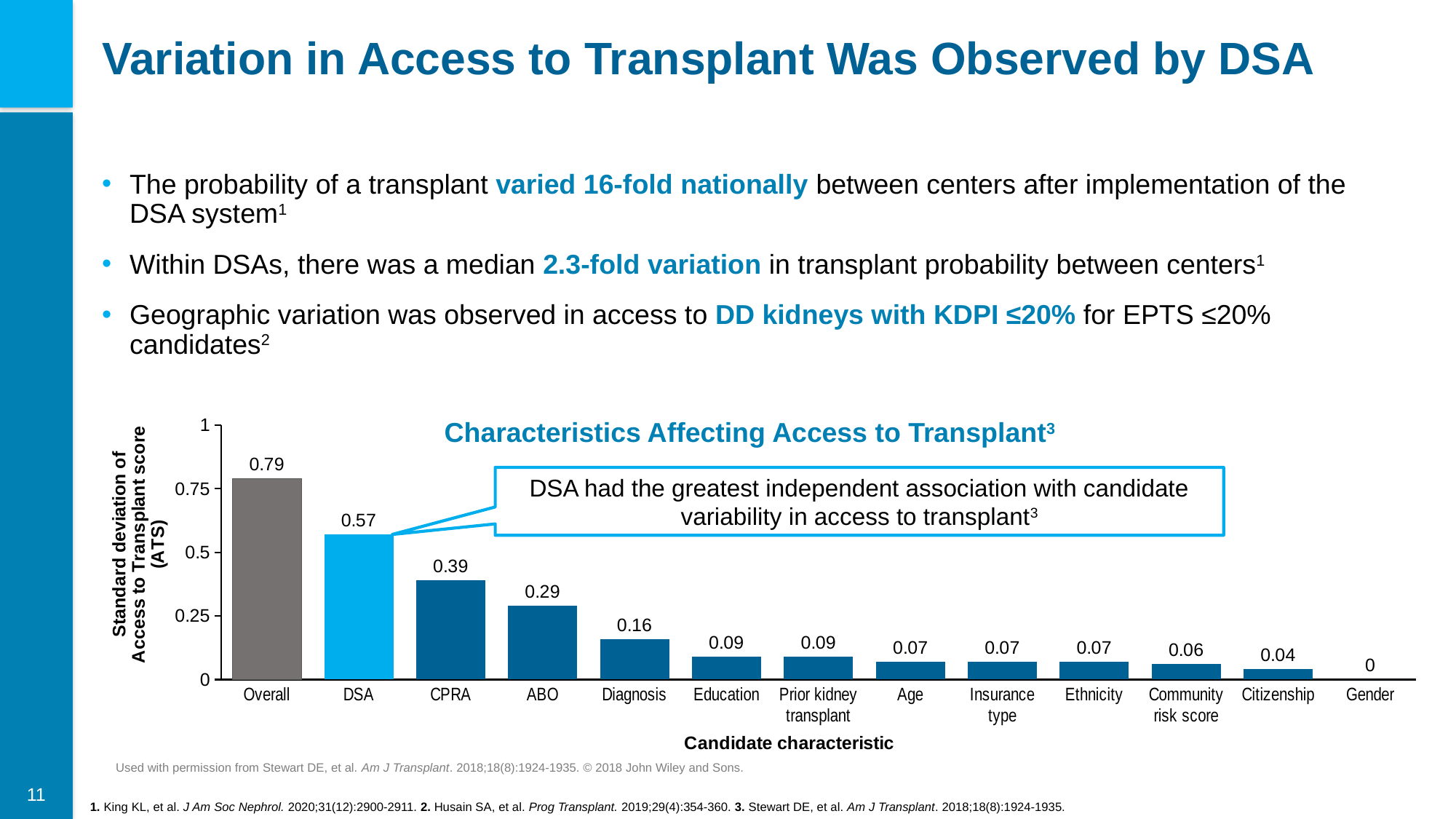
How many candidate characteristics are shown on the x axis? 13 Which candidate characteristic has the highest standard deviation of ATS? Overall What is the difference between the values for Overall and DSA? 0.22 Is the value for ABO greater or less than 0.25? greater What is the title of the chart? Characteristics Affecting Access to Transplant Which candidate characteristic has the lowest value? Gender What is the difference between the values for CPRA and ABO? 0.10 Which is larger, the value for Diagnosis or the value for Education? Diagnosis What is the value for Citizenship? 0.04 What is the value for DSA in the Characteristics Affecting Access to Transplant chart? 0.57 What is the value for CPRA? 0.39 What kind of chart is shown on the slide? Bar chart